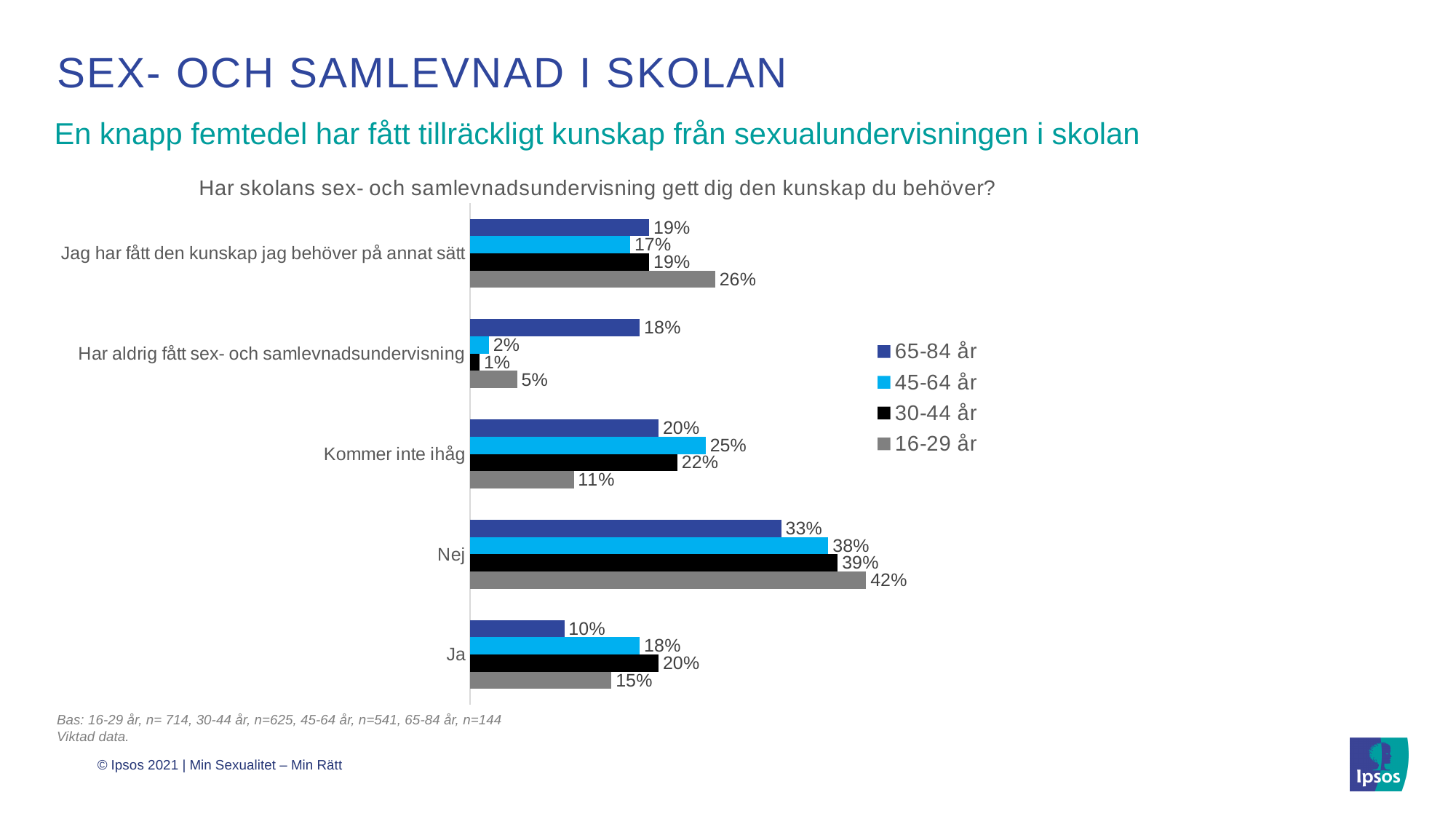
Which is larger for "Ja": the value for 30-44 år or the value for 16-29 år? 30-44 år Which age group has the lowest value for "Kommer inte ihåg"? 16-29 år What percentage of the 16-29 år group answered "Nej"? 42% How many series does the legend list? 4 How many answer categories are shown on the chart? 5 What is the value for 30-44 år in the "Har aldrig fått sex- och samlevnadsundervisning" category? 1% Which colour represents the 16-29 år group in the chart? Grey What percentage of the 65-84 år group answered "Ja"? 10% What is the value for 45-64 år in the "Kommer inte ihåg" category? 25% What is the difference between the 16-29 år and 65-84 år values for "Nej"? 9 percentage points Which age group has the highest value for "Har aldrig fått sex- och samlevnadsundervisning"? 65-84 år What type of chart is shown on the slide? Bar chart